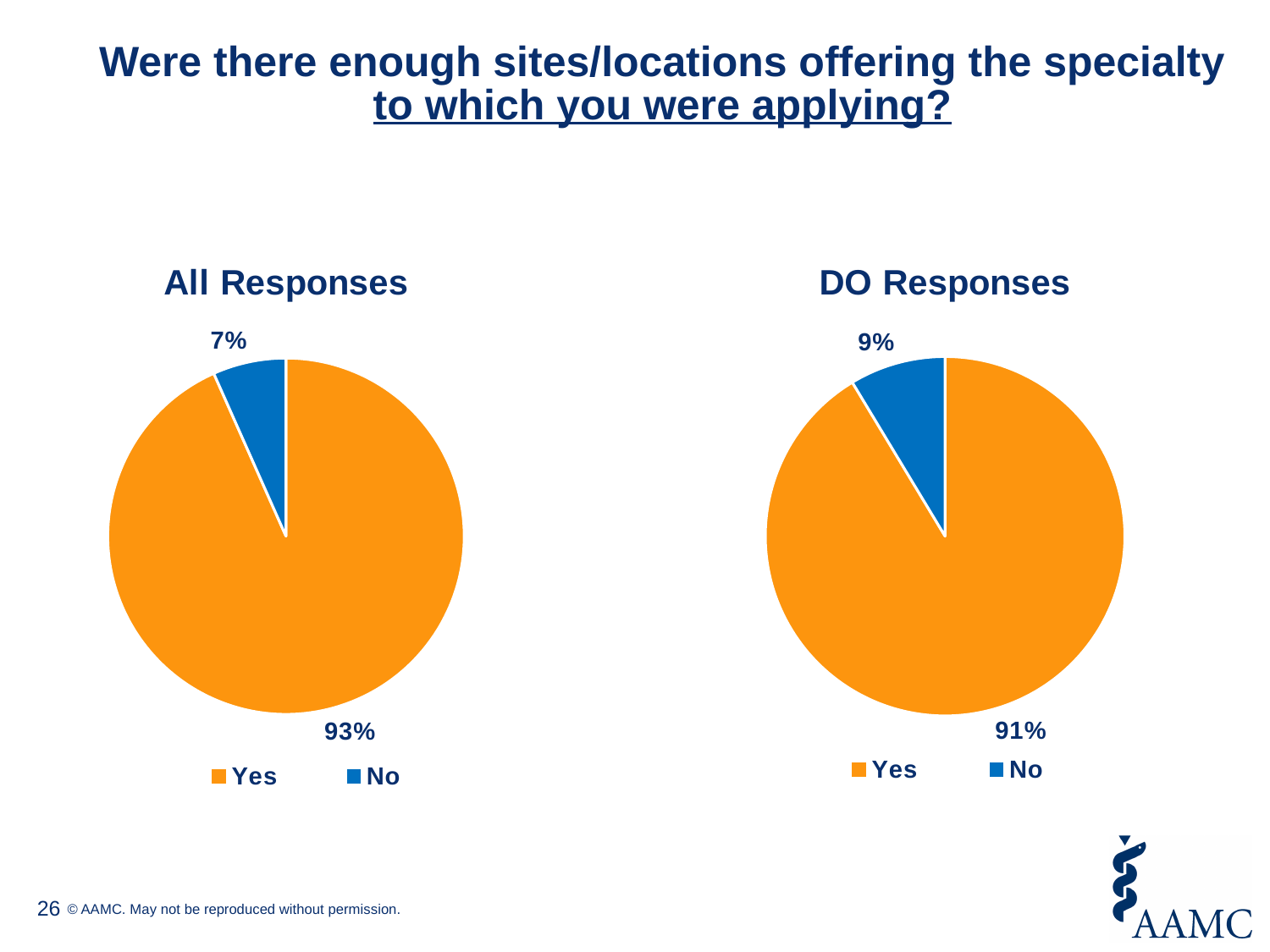
How many slices does the "All Responses" pie chart have? 2 Which chart shows a larger share of No responses, "All Responses" or "DO Responses"? DO Responses How many entries does the legend of the "DO Responses" chart list? 2 In the "DO Responses" pie chart, which response has the smallest share? No In the "DO Responses" pie chart, what percentage of respondents answered Yes? 91% In the "DO Responses" pie chart, what percentage of respondents answered No? 9% In the "All Responses" pie chart, which response has the largest share? Yes In the "All Responses" pie chart, what percentage of respondents answered No? 7% What type of chart is used for "DO Responses"? Pie chart In the "All Responses" pie chart, what is the difference in percentage points between the Yes and No shares? 86 In the "All Responses" pie chart, what colour represents the Yes slice? Orange In the "All Responses" pie chart, what percentage of respondents answered Yes? 93%